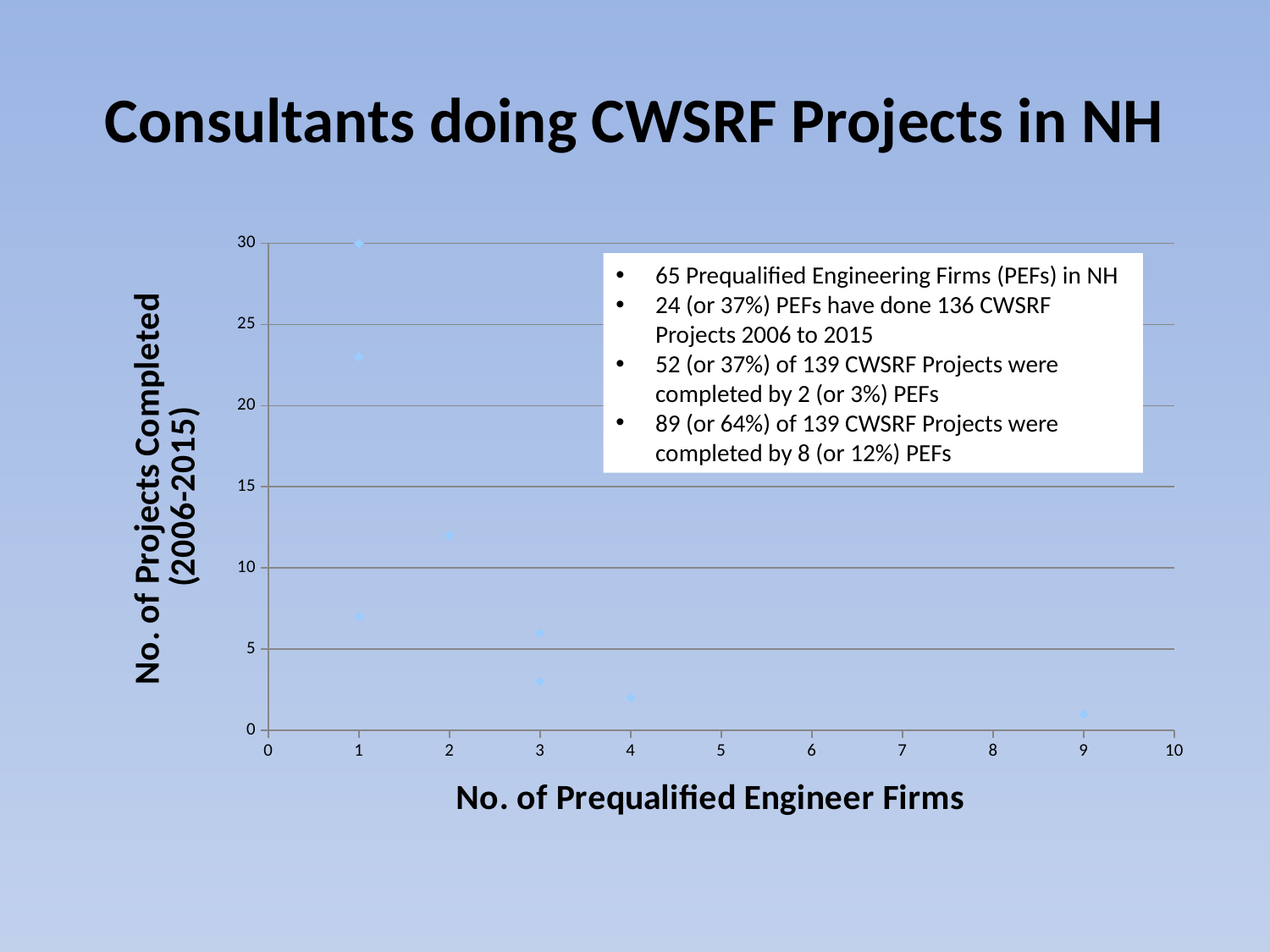
Is the value for the point at 9 prequalified engineer firms greater or less than 5? less What is the title of the chart? Consultants doing CWSRF Projects in NH Do the number of projects completed generally rise or fall as the number of prequalified engineer firms increases? fall Which has more projects completed: the point at 2 firms or the point at 4 firms? the point at 2 firms What is the label of the x axis? No. of Prequalified Engineer Firms What is the highest number of projects completed shown by any point on the chart? 30 How many data points are plotted on the chart? 8 At what number of prequalified engineer firms does the lowest point on the chart appear? 9 Is the value for the point at 4 prequalified engineer firms greater or less than 5? less What kind of chart is shown on the slide? scatter chart Is the value for the point at 2 prequalified engineer firms greater or less than 10? greater At what number of prequalified engineer firms does the highest point (30 projects) appear? 1